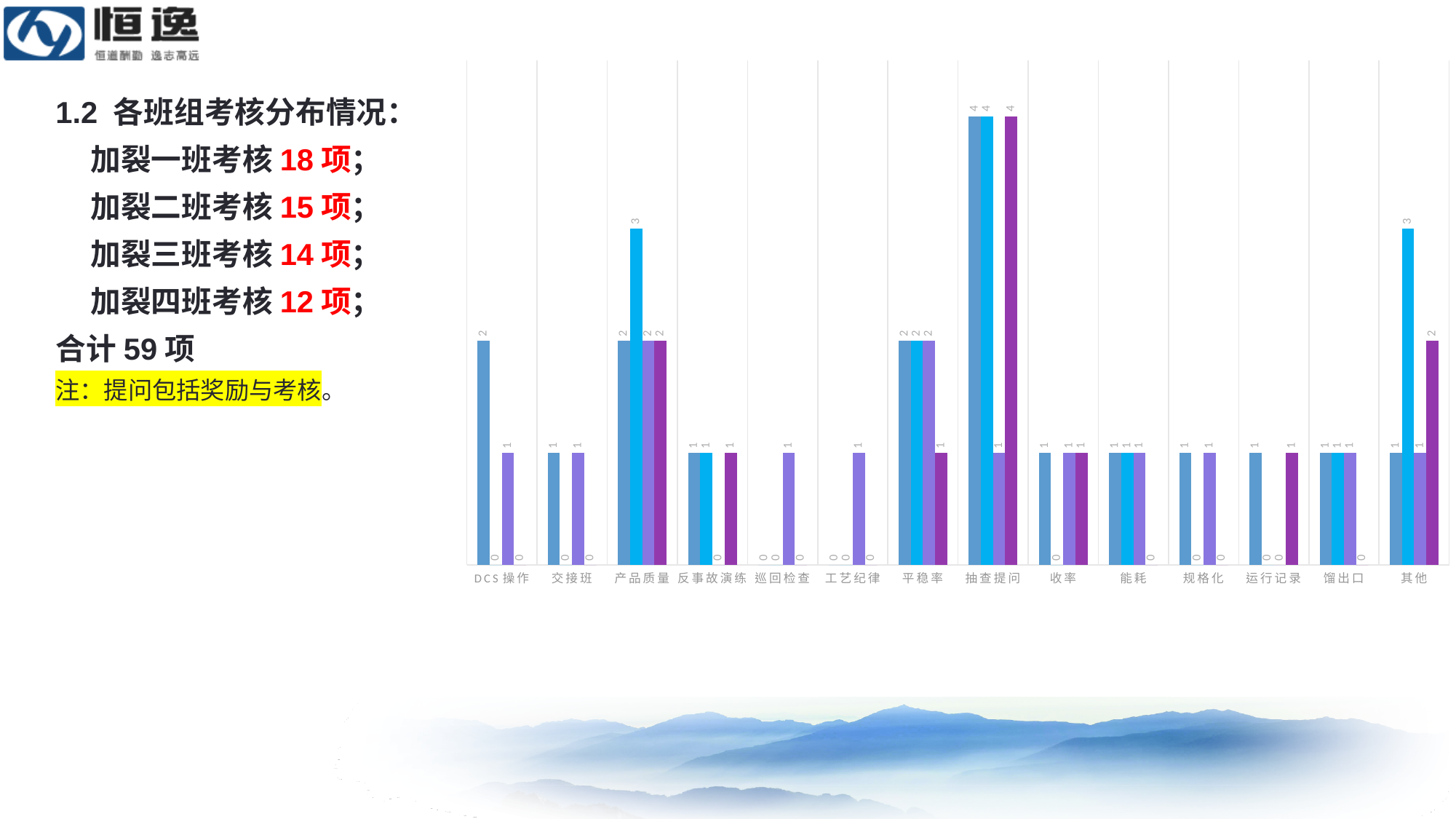
What is the value of the dark purple bar for 平稳率? 1 What is the difference between the cyan bar for 产品质量 and the cyan bar for 平稳率? 1 What kind of chart is shown on the slide? bar chart Which category has the highest bars in the chart? 抽查提问 Which is larger for 其他: the cyan bar or the dark purple bar? cyan bar What is the value of the light blue (first) bar for DCS操作? 2 What is the value of the cyan bar for 其他? 3 What is the value of the cyan bar for 产品质量? 3 How many categories are shown along the x axis of the chart? 14 Does the chart include a legend identifying the series? No What is the value of the dark purple bar for 抽查提问? 4 How many bars (series) are plotted for each category in the chart? 4